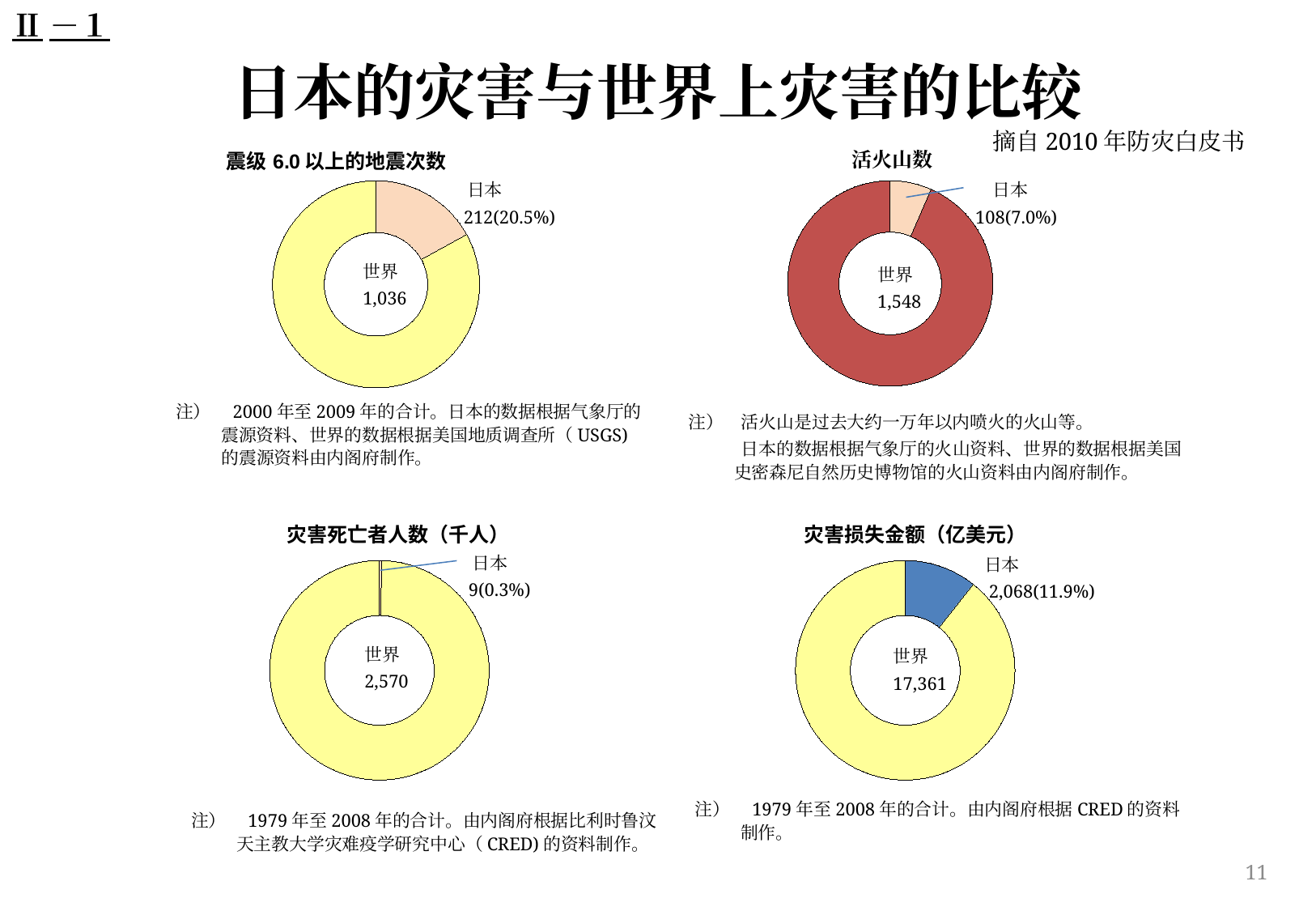
In the chart titled 灾害死亡者人数（千人）, what share of the total does 日本 account for? 0.3% In the chart titled 活火山数, what is the 世界 value shown in the centre? 1,548 In the chart titled 震级 6.0 以上的地震次数, what value is shown for 日本? 212 In the chart titled 活火山数, what value is shown for 日本? 108 In the chart titled 震级 6.0 以上的地震次数, what is the 世界 value shown in the centre? 1,036 How many charts are shown on the slide? 4 In the chart titled 灾害损失金额（亿美元）, what share of the total does 日本 account for? 11.9% What kind of chart is used for 灾害损失金额（亿美元）? Donut (pie) chart In the chart titled 活火山数, what share of the total does 日本 account for? 7.0% In the chart titled 灾害损失金额（亿美元）, what is the 世界 value shown in the centre? 17,361 In the chart titled 灾害死亡者人数（千人）, what value is shown for 日本? 9